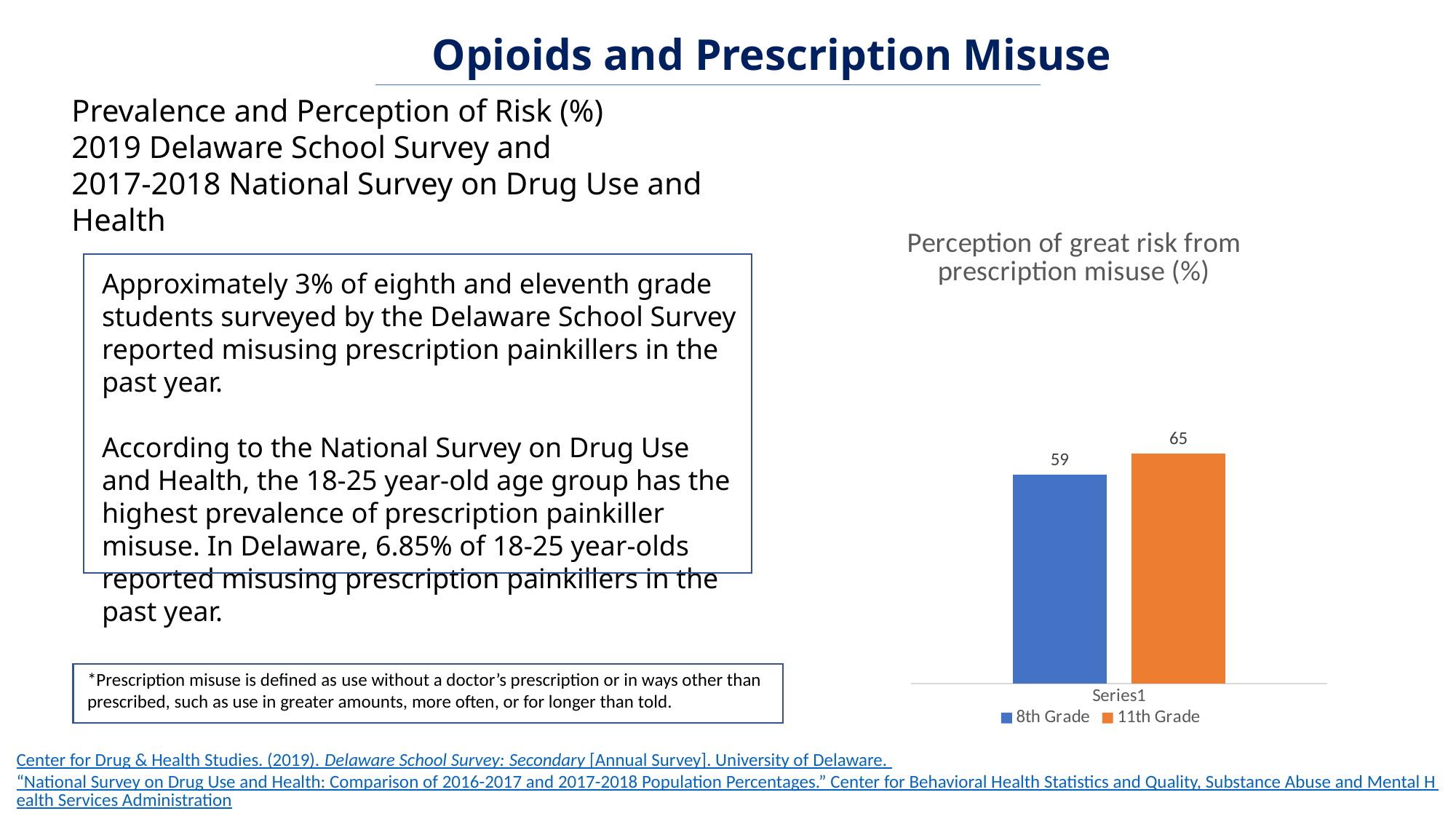
Is the value for 8th Grade larger or smaller than the value for 11th Grade? smaller Which series has the lower value in the chart? 8th Grade How many series does the legend list? 2 What kind of chart is shown on the slide? bar chart What is the category label shown on the x axis of the chart? Series1 What is the title of the chart? Perception of great risk from prescription misuse (%) What is the value for 11th Grade in the chart? 65 What colour is the bar for 11th Grade? orange What is the value for 8th Grade in the chart? 59 Which series has the higher value, 8th Grade or 11th Grade? 11th Grade What is the difference between the 11th Grade and 8th Grade values? 6